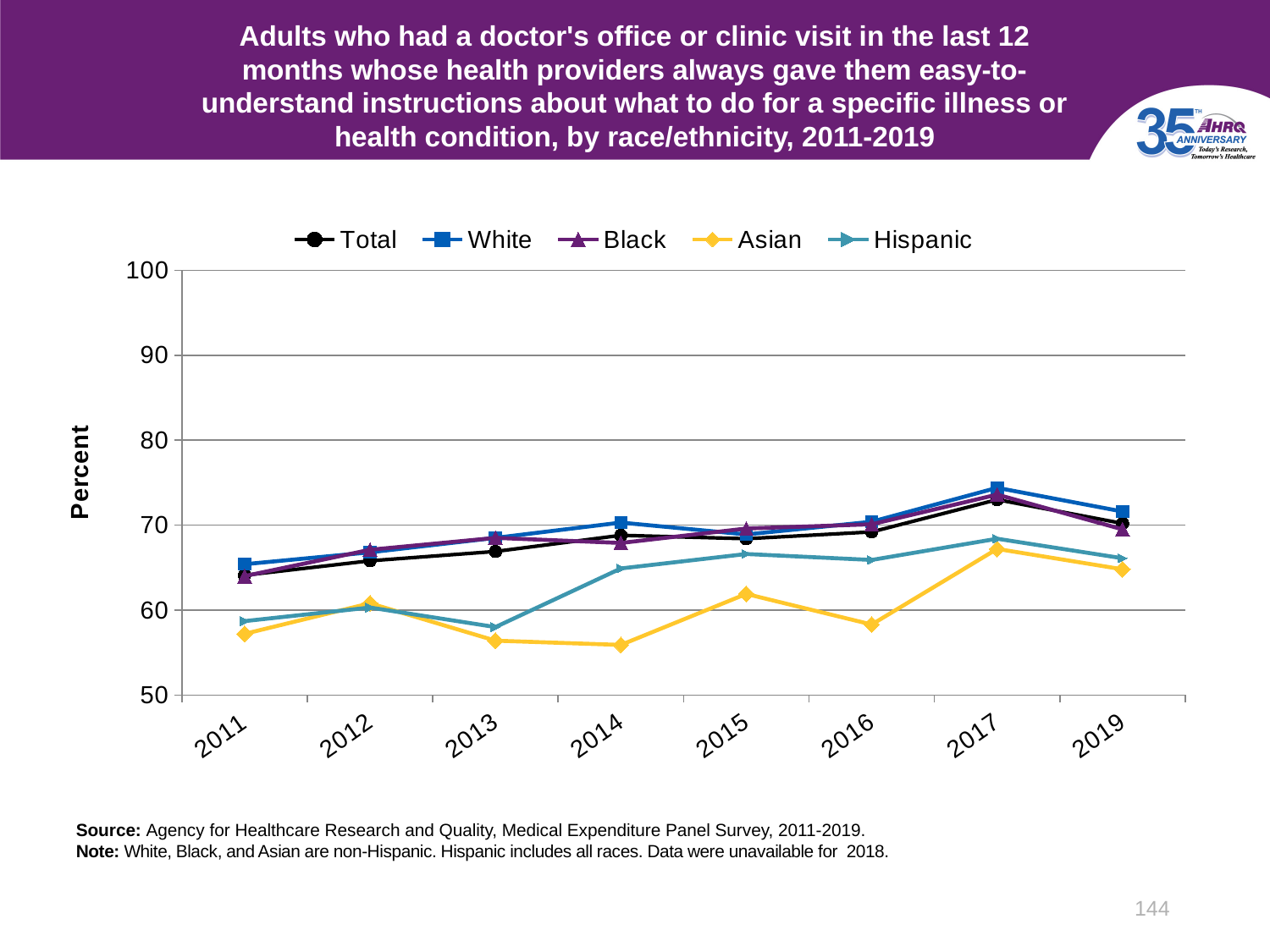
Which race/ethnicity group has the lowest value in 2014? Asian Is the value for White in 2017 greater or less than 70? greater Is the value for Asian in 2014 greater or less than 60? less In 2015, which is larger, the value for Asian or the value for Hispanic? Hispanic Is the value for Hispanic in 2011 greater or less than 60? less What kind of chart is shown on the slide? Line chart How many series does the legend list? 5 In which year does the Asian series reach its highest value? 2017 What is the label on the y axis? Percent How many years are plotted along the x axis? 8 Does the Hispanic series generally rise or fall from 2011 to 2017? Rise In 2019, which is larger, the value for White or the value for Black? White